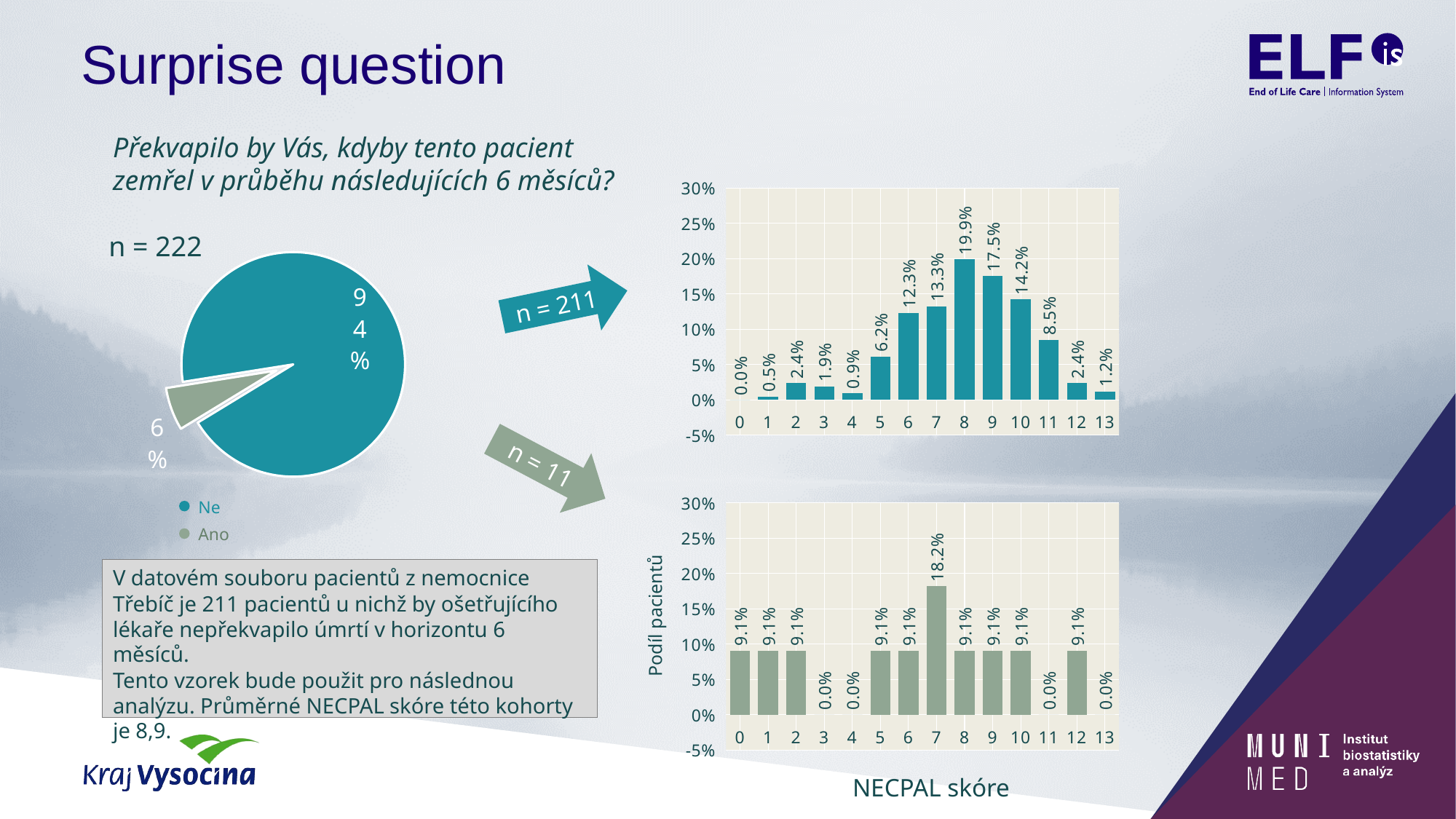
In the upper bar chart (n = 211), what is the difference between the values for NECPAL score 9 and NECPAL score 10? 3.3% In the lower bar chart (n = 11), what is the value for NECPAL score 7? 18.2% What kind of chart is the upper chart on the right side of the slide? Bar chart In the upper bar chart (n = 211), what is the value for NECPAL score 8? 19.9% In the lower bar chart (n = 11), what is the value for NECPAL score 11? 0.0% What is the x-axis label shown below the lower bar chart? NECPAL skóre In the pie chart, what is the value for 'Ano'? 6% In the upper bar chart (n = 211), which is larger, the value for NECPAL score 6 or NECPAL score 11? NECPAL score 6 In the upper bar chart (n = 211), which NECPAL score has the highest value? 8 In the pie chart, what share of the pie does the 'Ne' slice represent? 94% In the lower bar chart (n = 11), which NECPAL score has the highest value? 7 In the upper bar chart (n = 211), how many NECPAL score categories are shown on the x axis? 14